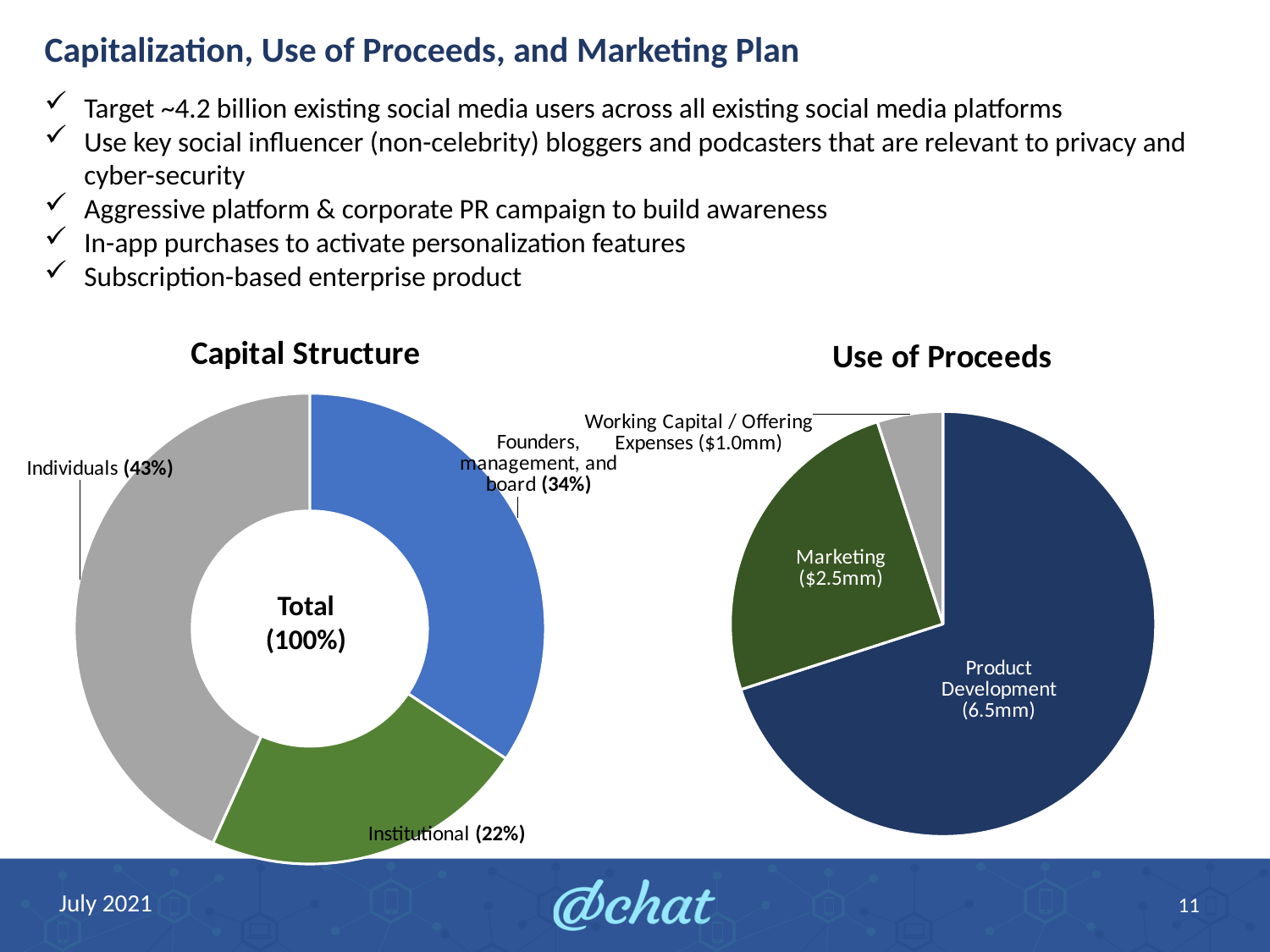
In the Use of Proceeds chart, which is larger: Marketing or Working Capital / Offering Expenses? Marketing In the Use of Proceeds chart, how many categories are shown? 3 In the Capital Structure chart, what share is held by Individuals? 43% In the Capital Structure chart, which group holds the smallest share? Institutional In the Use of Proceeds chart, which category receives the largest amount? Product Development In the Use of Proceeds chart, how much is allocated to Working Capital / Offering Expenses? $1.0mm In the Capital Structure chart, what share is held by Founders, management, and board? 34% In the Capital Structure chart, what share is held by Institutional investors? 22% In the Capital Structure chart, which group holds the largest share? Individuals What type of chart is the Use of Proceeds chart? Pie chart In the Use of Proceeds chart, how much is allocated to Marketing? $2.5mm In the Capital Structure chart, how many percentage points larger is the Individuals share than the Founders, management, and board share? 9 percentage points